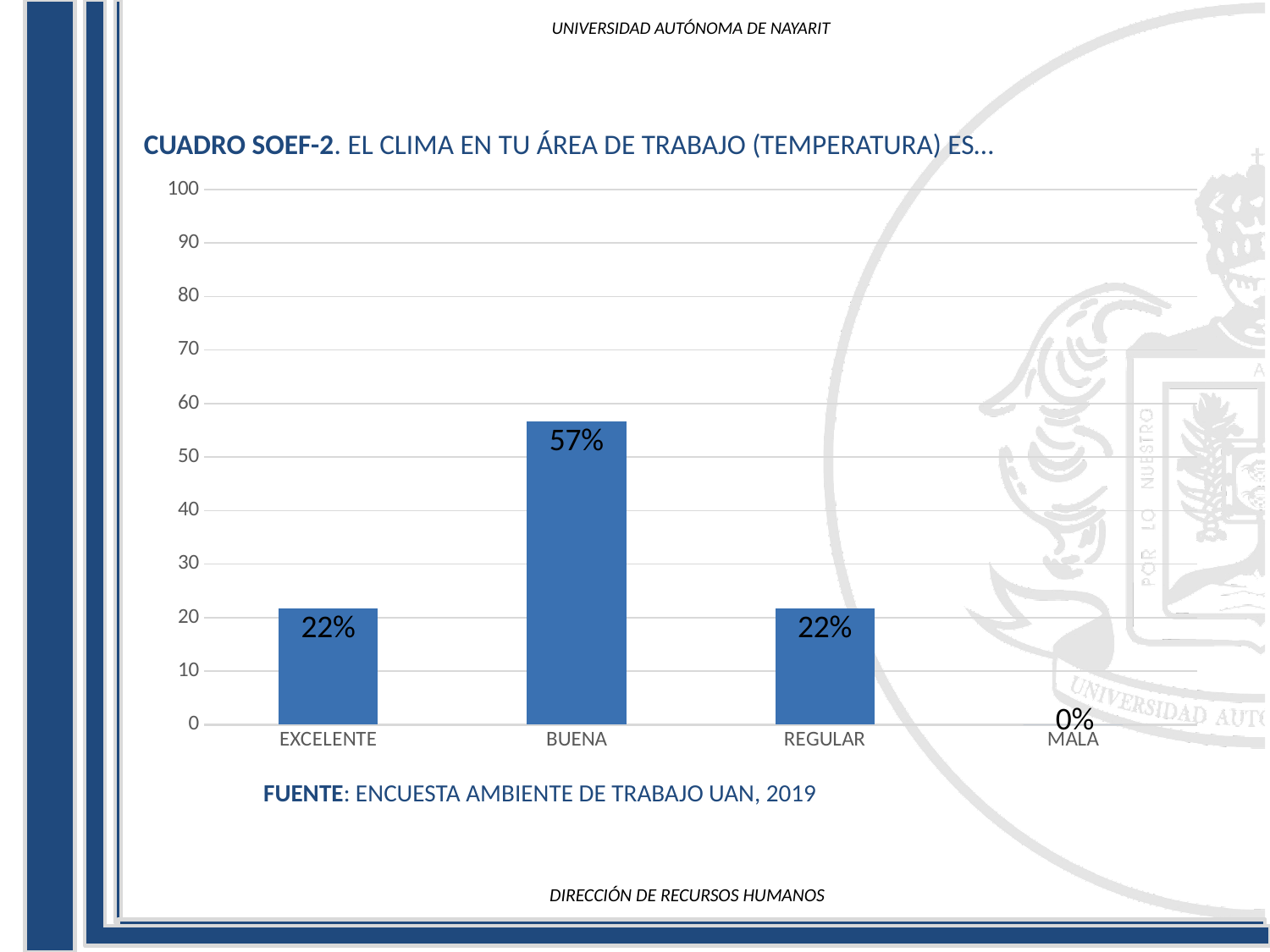
What is the title of the chart? CUADRO SOEF-2. EL CLIMA EN TU ÁREA DE TRABAJO (TEMPERATURA) ES… Which category has the lowest value? MALA Is the value for BUENA greater or less than 50? greater What kind of chart is shown on the slide? bar chart What source is cited below the chart? ENCUESTA AMBIENTE DE TRABAJO UAN, 2019 Which is larger, the value for BUENA or the value for EXCELENTE? BUENA How many categories are shown on the x axis? 4 What is the value for EXCELENTE? 22% What is the value for BUENA? 57% Which category has the highest value? BUENA What is the difference between the values for BUENA and REGULAR? 35% What is the value for MALA? 0%